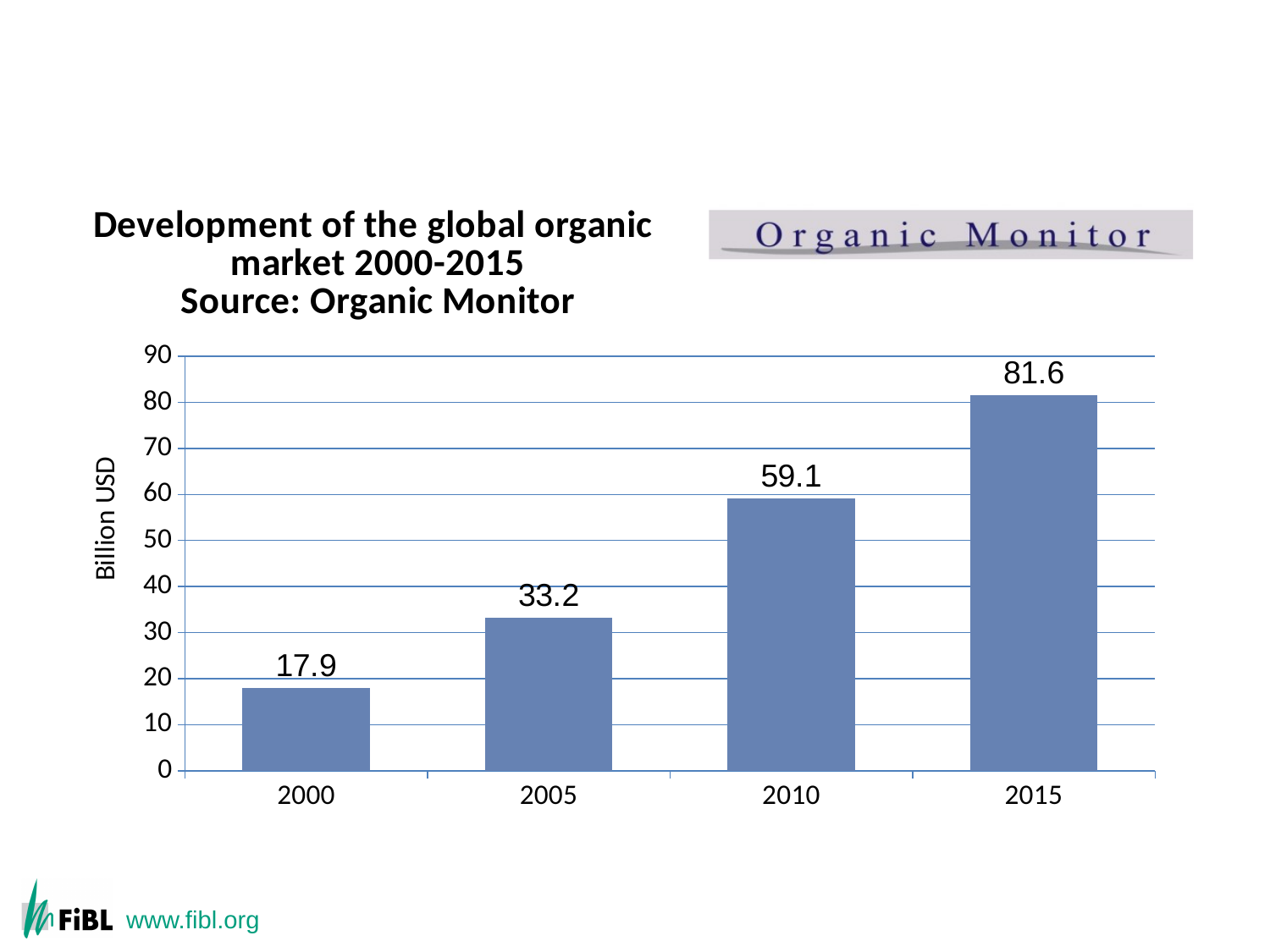
What is the value for 2015? 81.6 Which year has the highest value? 2015 What is the value for 2000? 17.9 How many years are shown on the x axis? 4 What is the difference between the values for 2015 and 2000? 63.7 What is the value for 2005? 33.2 What kind of chart is this? bar chart What is the value for 2010? 59.1 Do the values rise or fall from 2000 to 2015? rise Which year has the lowest value? 2000 Which is larger, the value for 2005 or the value for 2010? 2010 What is the difference between the values for 2010 and 2005? 25.9